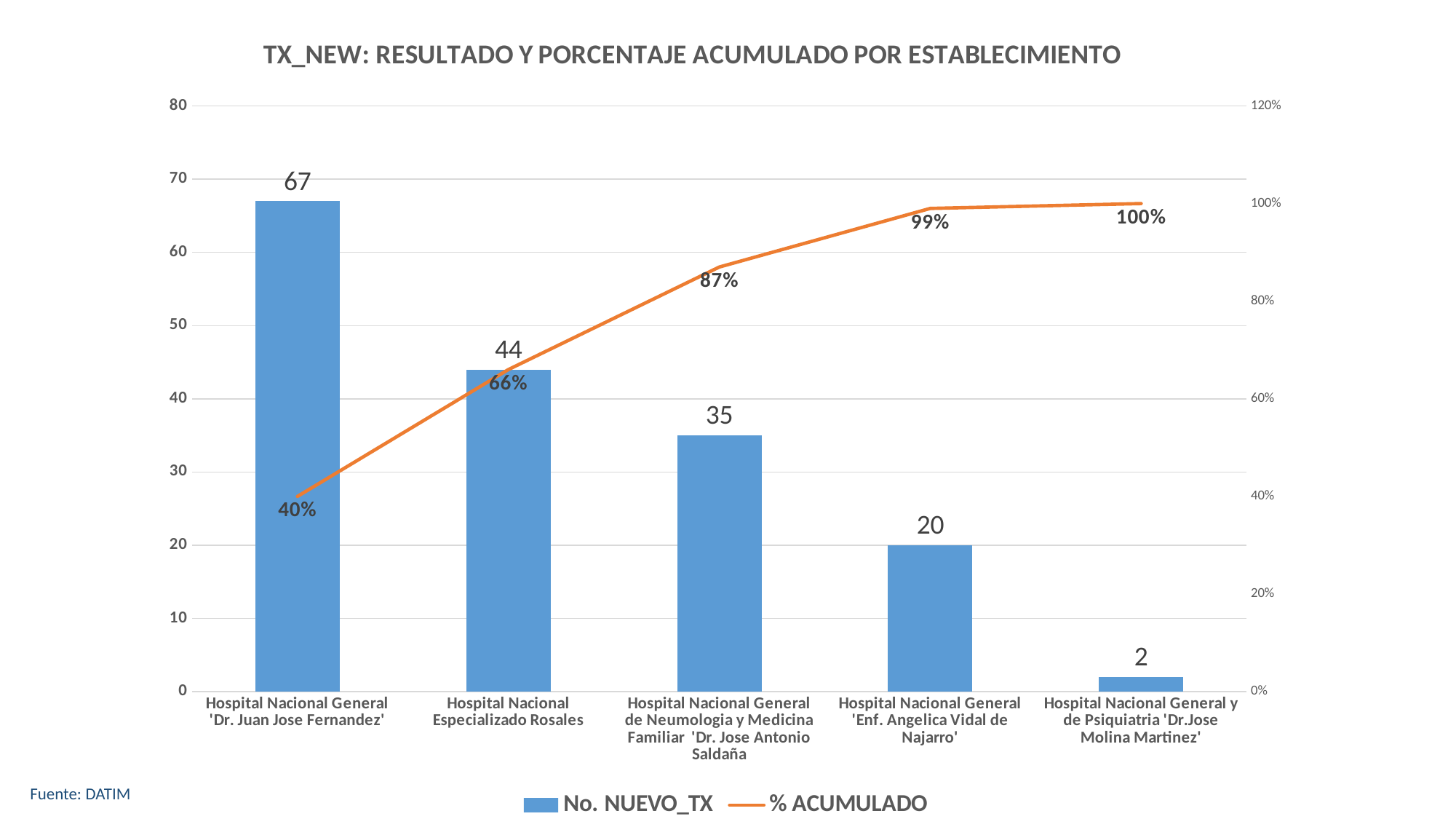
What is the No. NUEVO_TX value for Hospital Nacional General 'Enf. Angelica Vidal de Najarro'? 20 How many series does the legend list? 2 Which establishment has the lowest No. NUEVO_TX value? Hospital Nacional General y de Psiquiatria 'Dr.Jose Molina Martinez' Do the No. NUEVO_TX bar values rise or fall from left to right along the x axis? Fall What is the difference in No. NUEVO_TX between Hospital Nacional General 'Dr. Juan Jose Fernandez' and Hospital Nacional Especializado Rosales? 23 What is the title of the chart? TX_NEW: RESULTADO Y PORCENTAJE ACUMULADO POR ESTABLECIMIENTO How many establishments are shown on the x axis? 5 What is the % ACUMULADO value at Hospital Nacional General de Neumologia y Medicina Familiar 'Dr. Jose Antonio Saldaña'? 87% Which has a larger No. NUEVO_TX value: Hospital Nacional General de Neumologia y Medicina Familiar 'Dr. Jose Antonio Saldaña' or Hospital Nacional General 'Enf. Angelica Vidal de Najarro'? Hospital Nacional General de Neumologia y Medicina Familiar 'Dr. Jose Antonio Saldaña' Which establishment has the highest No. NUEVO_TX value? Hospital Nacional General 'Dr. Juan Jose Fernandez' What kind of chart is this? Combined bar and line chart What is the No. NUEVO_TX value for Hospital Nacional Especializado Rosales? 44